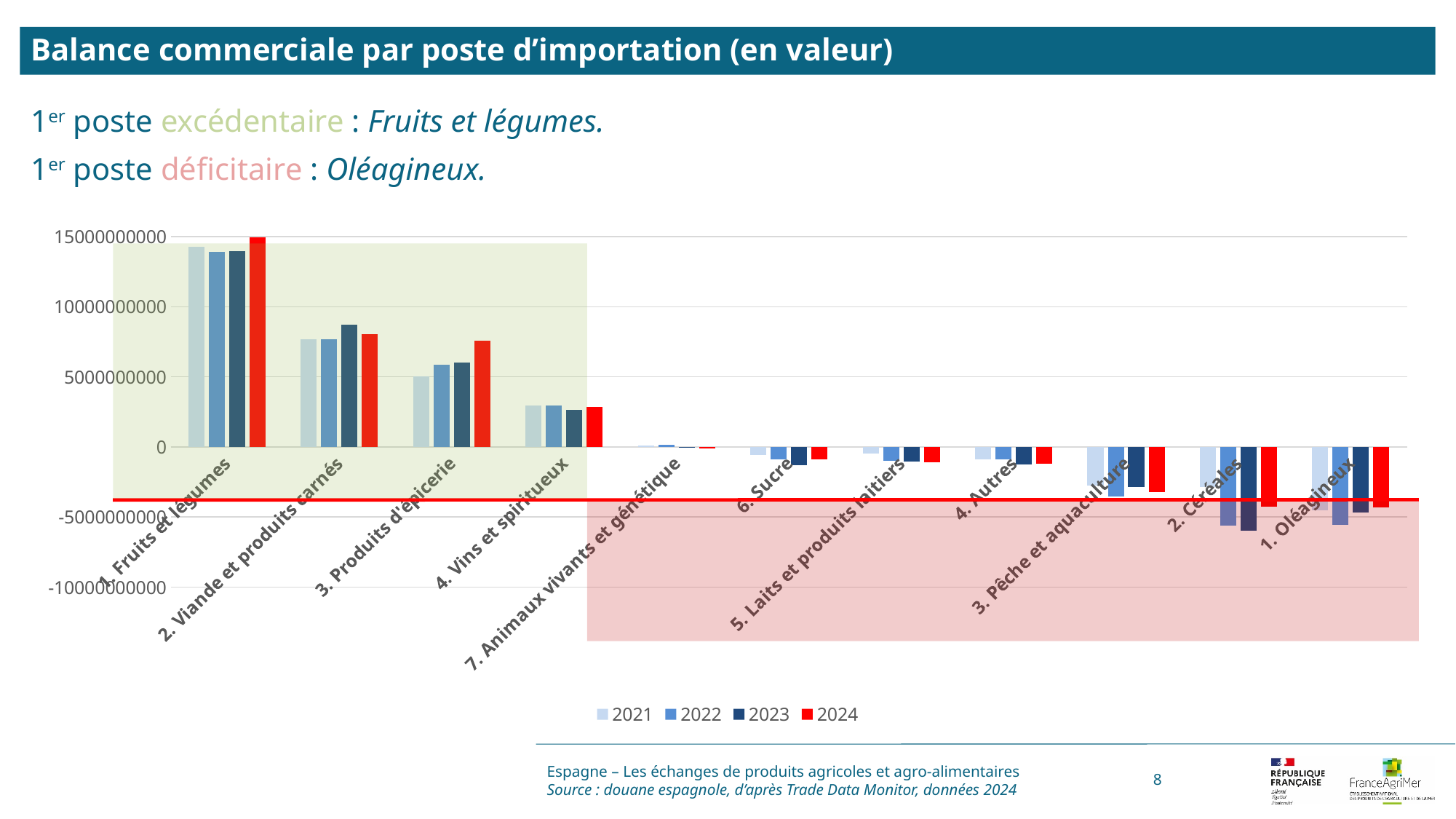
Do the values for 3. Produits d'épicerie rise or fall from 2021 to 2024? rise How many series does the legend list? 4 Is the 2024 value for 3. Pêche et aquaculture greater or less than -5000000000? greater Is the 2023 value for 2. Viande et produits carnés greater or less than 5000000000? greater Which colour represents the 2024 series in the legend? red Is the 2023 value for 2. Céréales greater or less than -5000000000? less What kind of chart is shown on the slide? bar chart How many categories are shown on the x axis of the chart? 11 Which is larger for 2024: 1. Fruits et légumes or 2. Viande et produits carnés? 1. Fruits et légumes Which category has the highest value for 2024? 1. Fruits et légumes